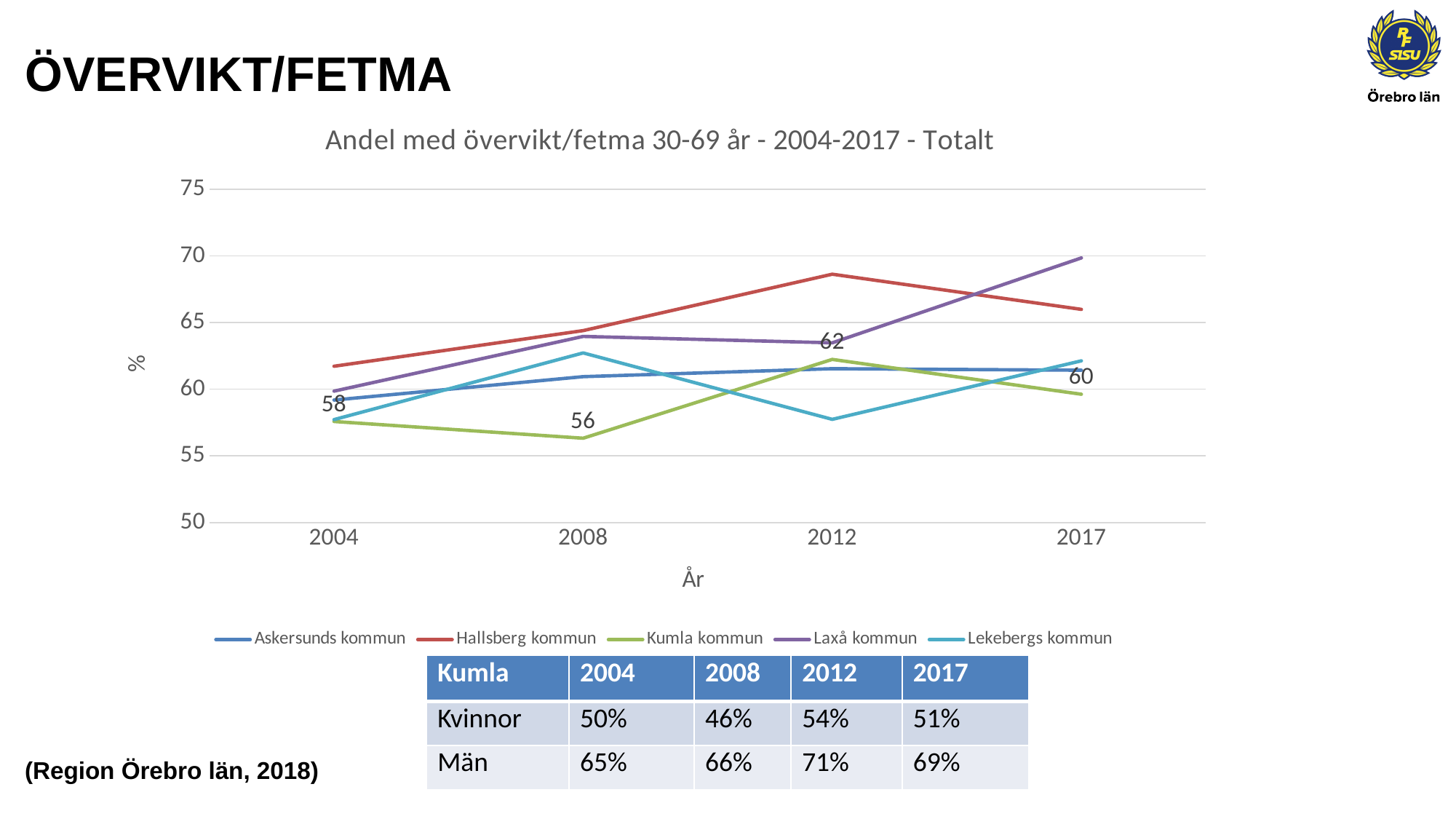
What is the labelled value for Kumla kommun in 2017? 60 How many series does the legend list? 5 Is the value for Laxå kommun in 2017 greater or less than 65? greater Which municipality has the highest value in 2017? Laxå kommun Which municipality has the lowest value in 2008? Kumla kommun Which municipality has the highest value in 2012? Hallsberg kommun What is the labelled value for Kumla kommun in 2008? 56 What is the labelled value for Kumla kommun in 2012? 62 How many years are plotted along the x axis? 4 Does the value for Hallsberg kommun rise or fall from 2012 to 2017? fall By how much did the labelled value for Kumla kommun increase from 2008 to 2012? 6 What kind of chart is shown on the slide? line chart